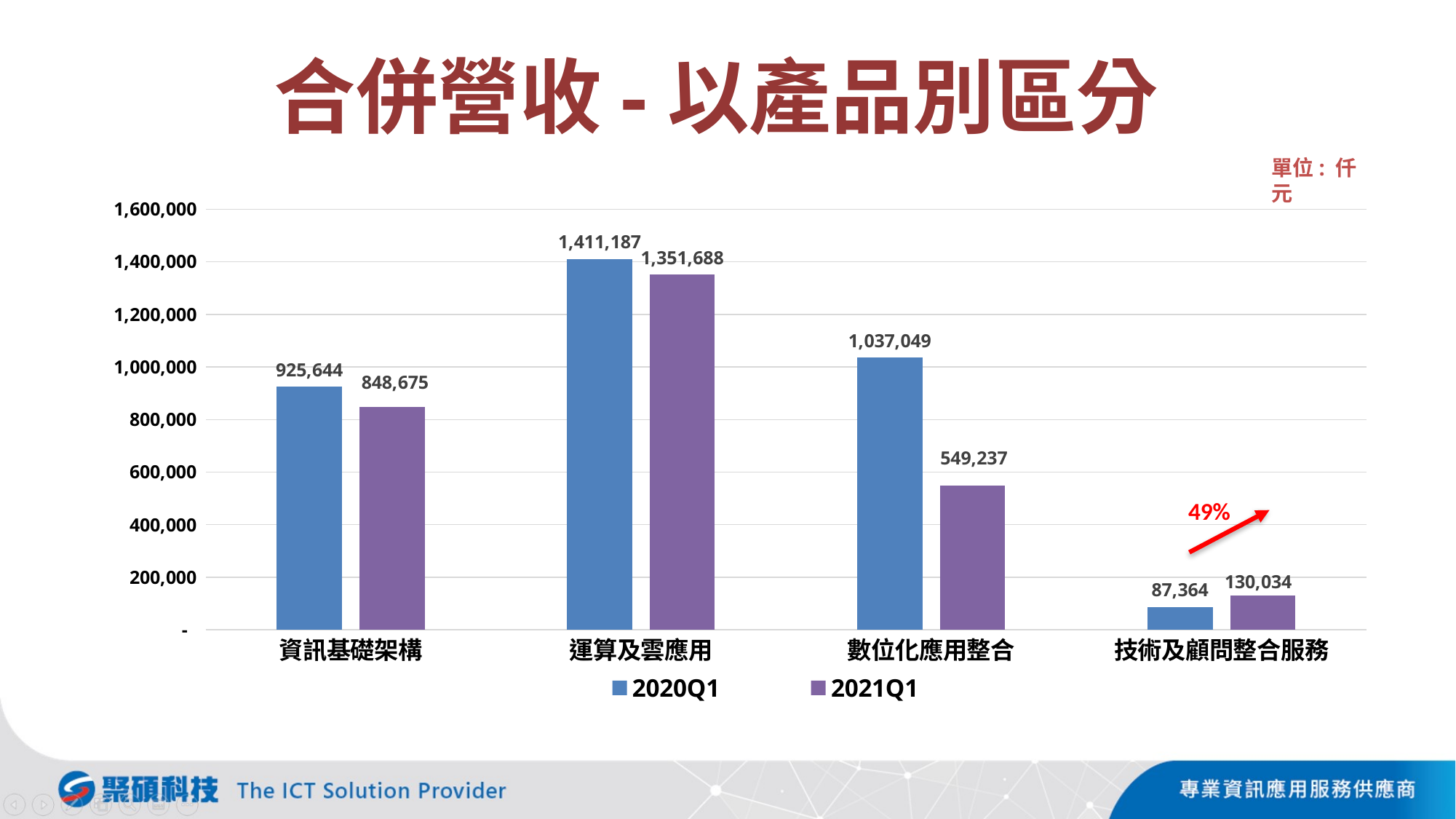
What is the 2020Q1 value for 資訊基礎架構? 925,644 How many product categories are shown on the x axis? 4 What percentage is written next to the red arrow above 技術及顧問整合服務? 49% How many series does the legend list? 2 Which category has the lowest 2020Q1 value? 技術及顧問整合服務 For 技術及顧問整合服務, which is larger: the 2020Q1 value or the 2021Q1 value? 2021Q1 What is the 2021Q1 value for 運算及雲應用? 1,351,688 What is the 2020Q1 value for 技術及顧問整合服務? 87,364 What type of chart is shown on the slide? bar chart What is the difference between the 2020Q1 and 2021Q1 values for 數位化應用整合? 487,812 What is the 2021Q1 value for 數位化應用整合? 549,237 Which category has the highest 2021Q1 value? 運算及雲應用